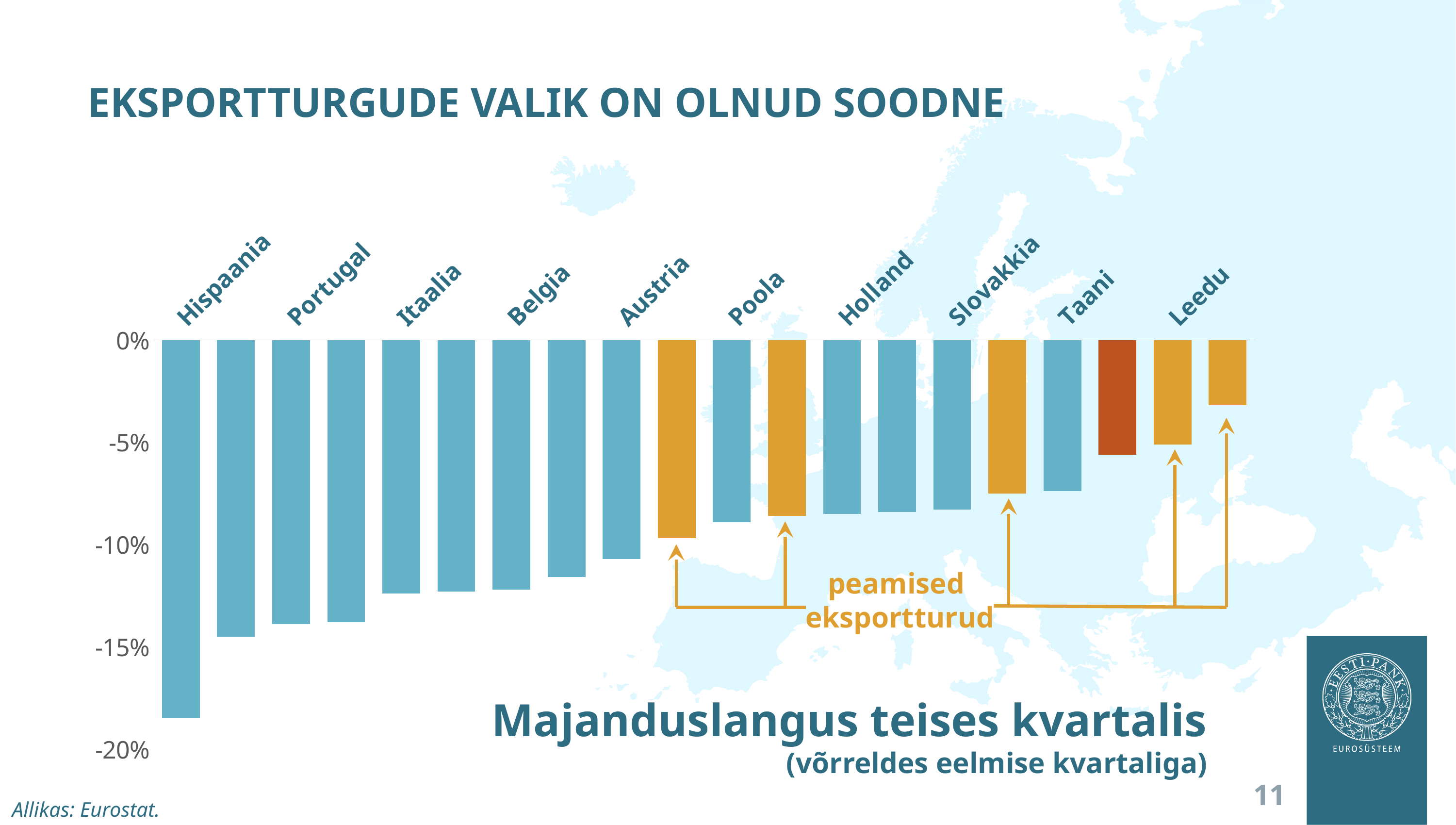
Do the values rise or fall moving from left to right along the x axis? rise Is the value for Holland greater or less than -10%? greater What kind of chart is shown on the slide? bar chart Is the value for Hispaania greater or less than -15%? less What do the orange bars in the chart represent, according to the annotation? peamised eksportturud Which has the higher (less negative) value, Hispaania or Leedu? Leedu How many bars are plotted in the chart? 20 Which labelled country has the lowest (most negative) value in the chart? Hispaania Is the value for Portugal greater or less than -10%? less Which has the higher (less negative) value, Itaalia or Holland? Holland